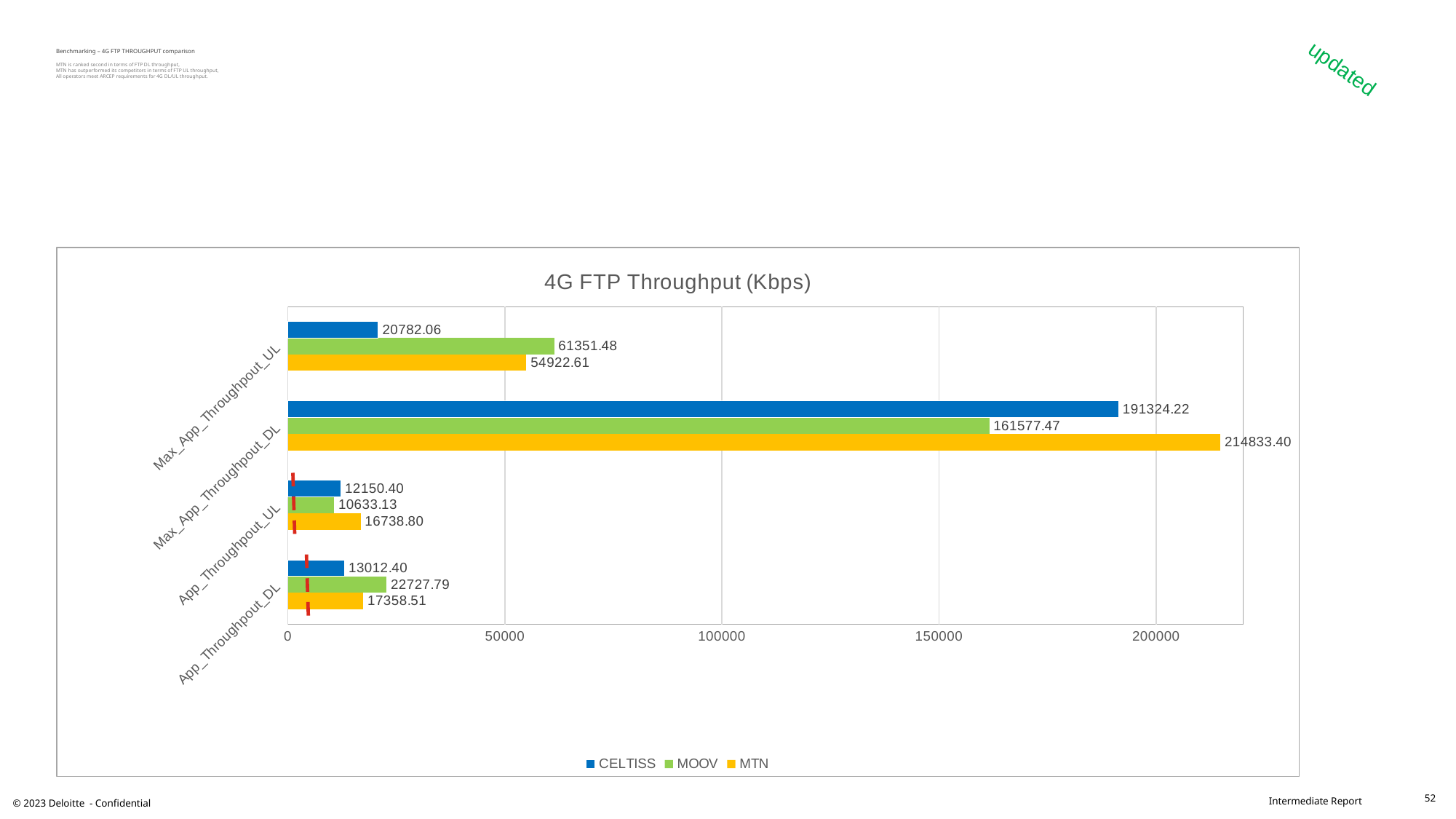
Is the CELTISS value for Max_App_Throughpout_DL greater or less than 150000? greater Which operator has the highest value for Max_App_Throughpout_DL? MTN Which operator has the lowest value for App_Throughpout_UL? MOOV What is the MOOV value for Max_App_Throughpout_UL? 61351.48 Which is larger for App_Throughpout_DL: the MOOV value or the MTN value? MOOV What is the MTN value for Max_App_Throughpout_DL? 214833.40 How many categories are shown on the vertical axis? 4 What is the title of the chart? 4G FTP Throughput (Kbps) What is the difference between the MTN and CELTISS values for Max_App_Throughpout_DL? 23509.18 How many series does the legend list? 3 What is the CELTISS value for App_Throughpout_DL? 13012.40 What type of chart is shown on the slide? Bar chart